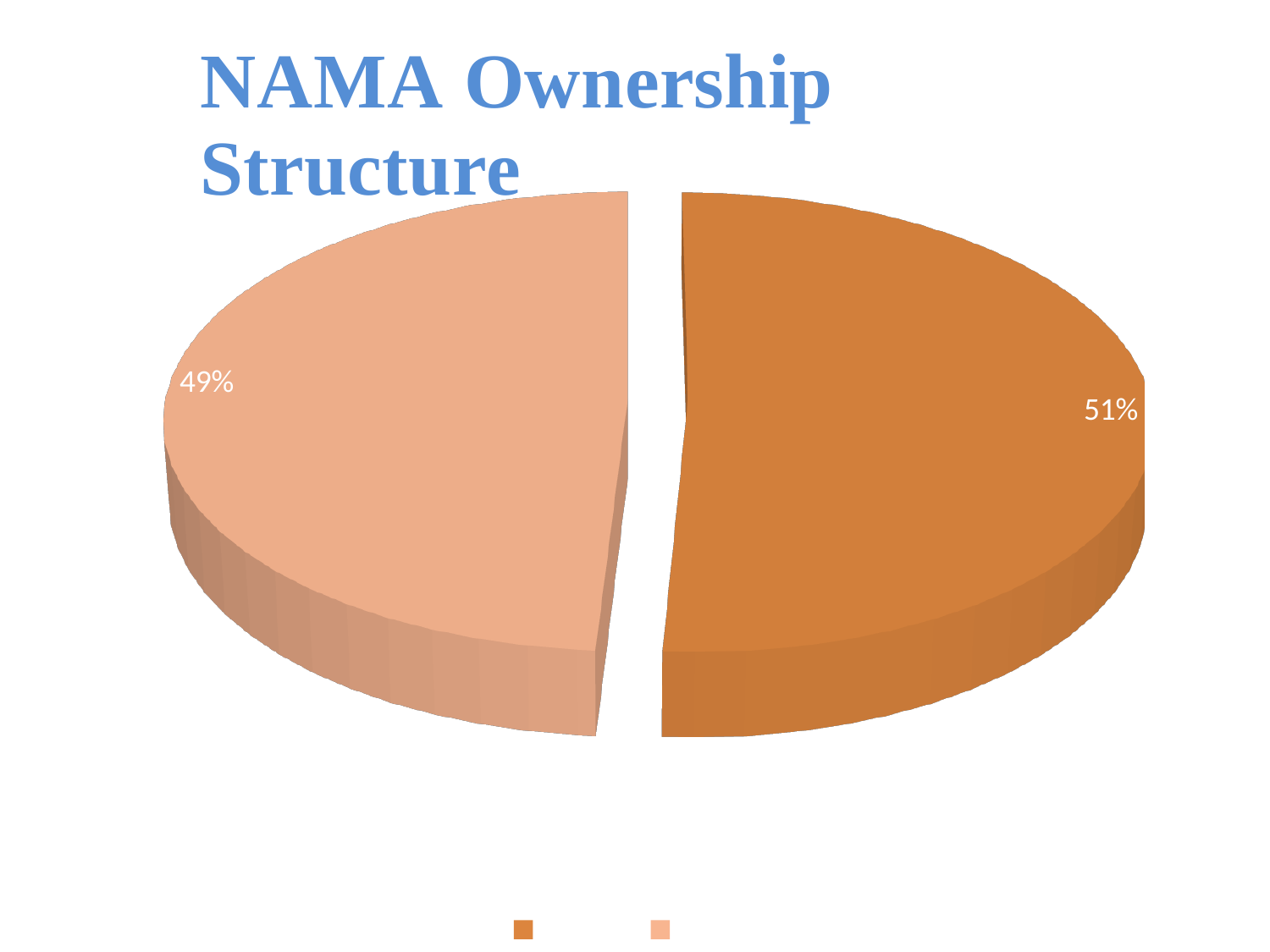
What percentage is shown on the lighter orange slice on the left side of the pie? 49% Which slice is the largest in the pie chart? The darker orange slice on the right (51%) How many slices does the pie chart have? 2 How many entries does the legend show? 2 Which is larger, the left slice or the right slice? The right slice Which slice is the smallest in the pie chart? The lighter orange slice on the left (49%) What kind of chart is shown on the slide? Pie chart What percentage is shown on the darker orange slice on the right side of the pie? 51% What is the difference in percentage points between the two slices? 2 percentage points What is the title of the chart? NAMA Ownership Structure What do the two slice percentages add up to? 100% What share of the pie does the darker orange slice represent? 51%